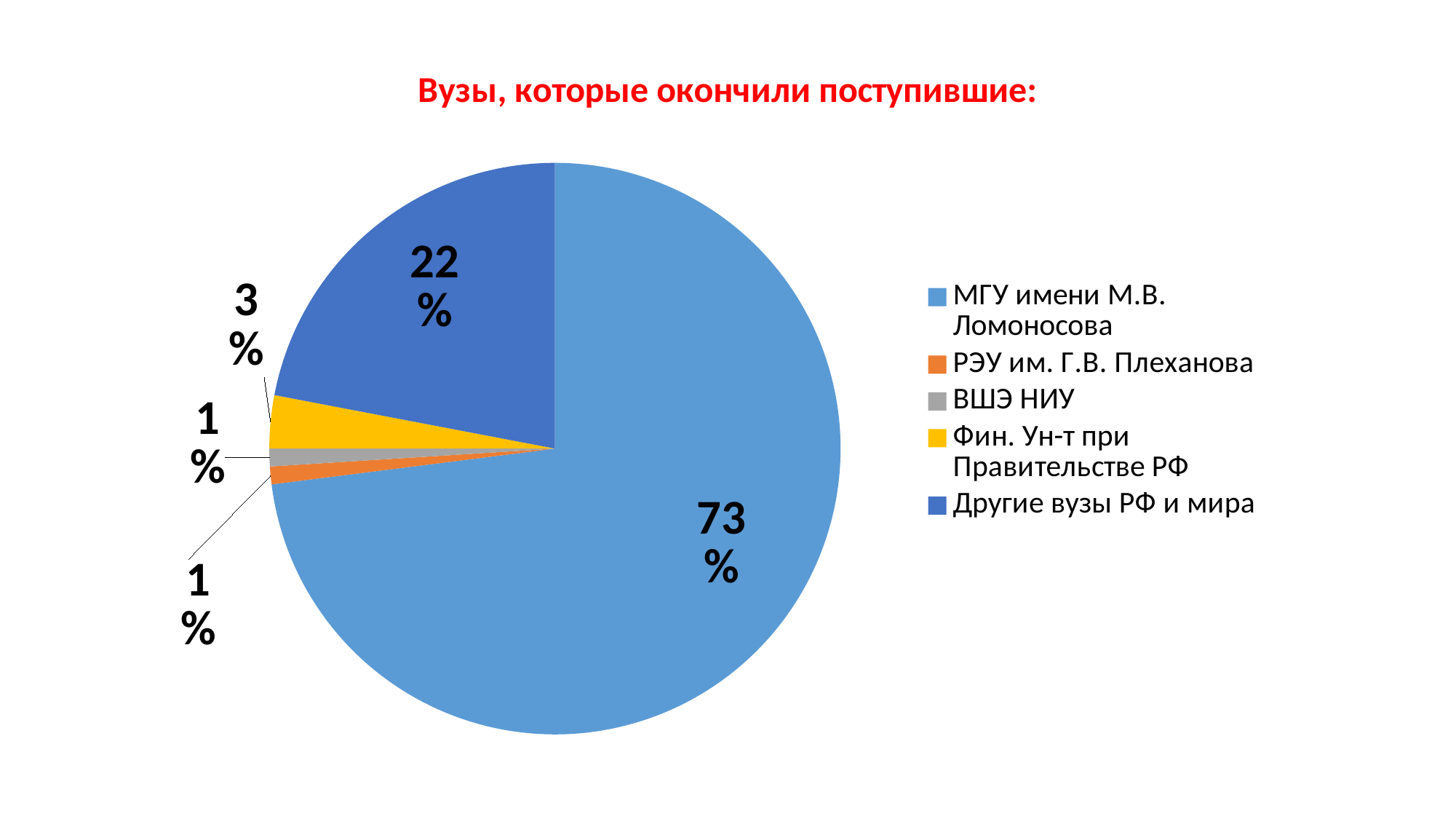
What is the difference between the share for МГУ имени М.В. Ломоносова and the share for Другие вузы РФ и мира? 51 percentage points How many categories does the pie chart show? 5 Which is larger: the share for Фин. Ун-т при Правительстве РФ or the share for ВШЭ НИУ? Фин. Ун-т при Правительстве РФ Which category has the largest slice of the pie? МГУ имени М.В. Ломоносова What share of the pie does МГУ имени М.В. Ломоносова hold? 73% What is the value shown for РЭУ им. Г.В. Плеханова? 1% What is the value shown for Фин. Ун-т при Правительстве РФ? 3% What is the value shown for ВШЭ НИУ? 1% Which is larger: the share for Другие вузы РФ и мира or the share for Фин. Ун-т при Правительстве РФ? Другие вузы РФ и мира What is the title of the chart? Вузы, которые окончили поступившие: What kind of chart is shown on the slide? Pie chart What share of the pie does Другие вузы РФ и мира hold? 22%